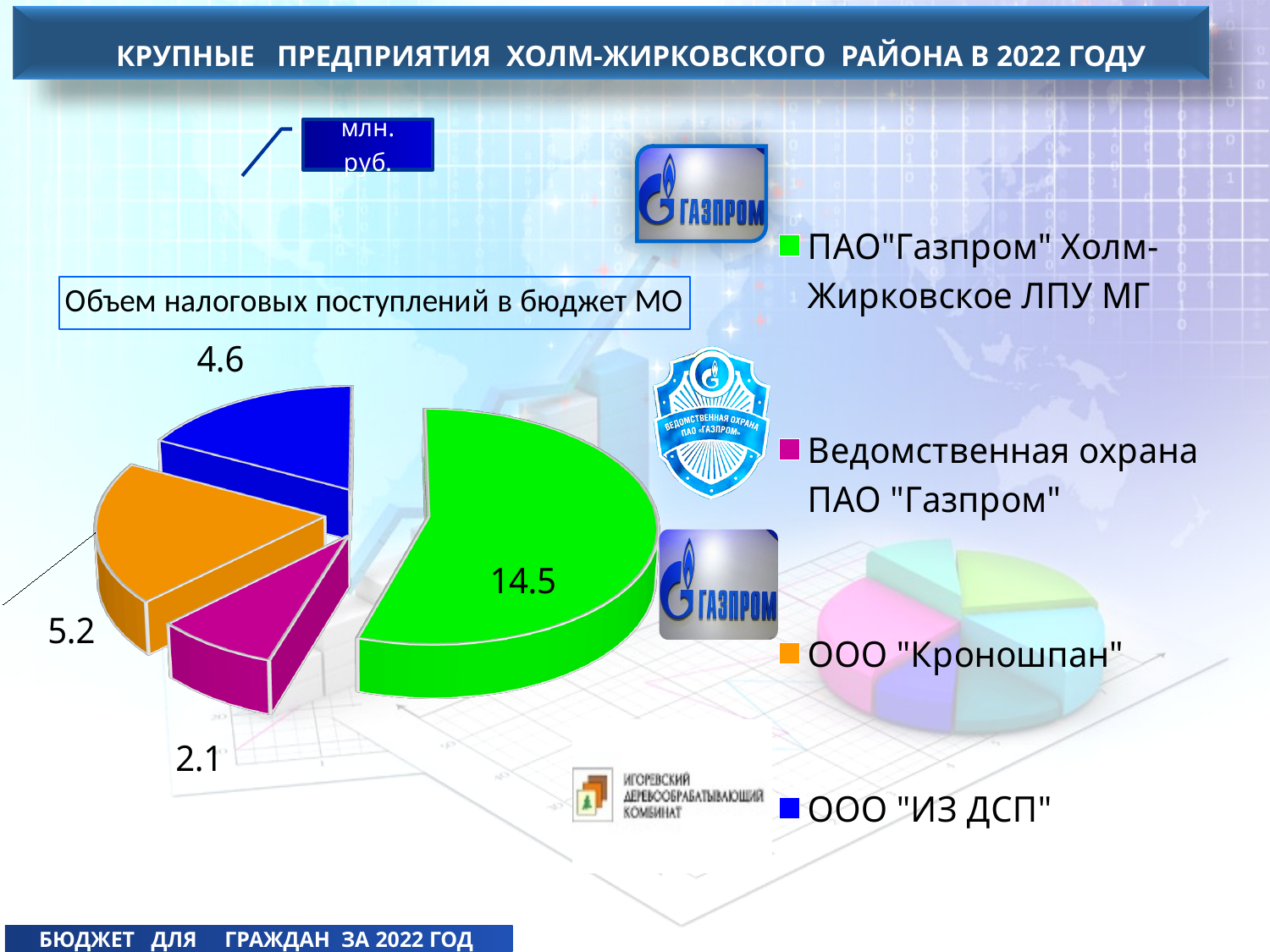
Which enterprise has the smallest slice in the pie chart? Ведомственная охрана ПАО "Газпром" How many enterprises (slices) are shown in the pie chart? 4 What is the value for ООО "ИЗ ДСП" in the pie chart? 4.6 What type of chart is used to show "Объем налоговых поступлений в бюджет МО"? pie chart What is the value for Ведомственная охрана ПАО "Газпром" in the pie chart? 2.1 What is the value for ПАО "Газпром" Холм-Жирковское ЛПУ МГ in the pie chart? 14.5 What is the value for ООО "Кроношпан" in the pie chart? 5.2 What is the difference between the values for ООО "Кроношпан" and ООО "ИЗ ДСП"? 0.6 Which is larger: the value for ООО "Кроношпан" or the value for ООО "ИЗ ДСП"? ООО "Кроношпан" In what units are the values of the pie chart given? млн. руб. What is the total of all slices in the pie chart? 26.4 Which enterprise has the largest slice in the pie chart? ПАО "Газпром" Холм-Жирковское ЛПУ МГ